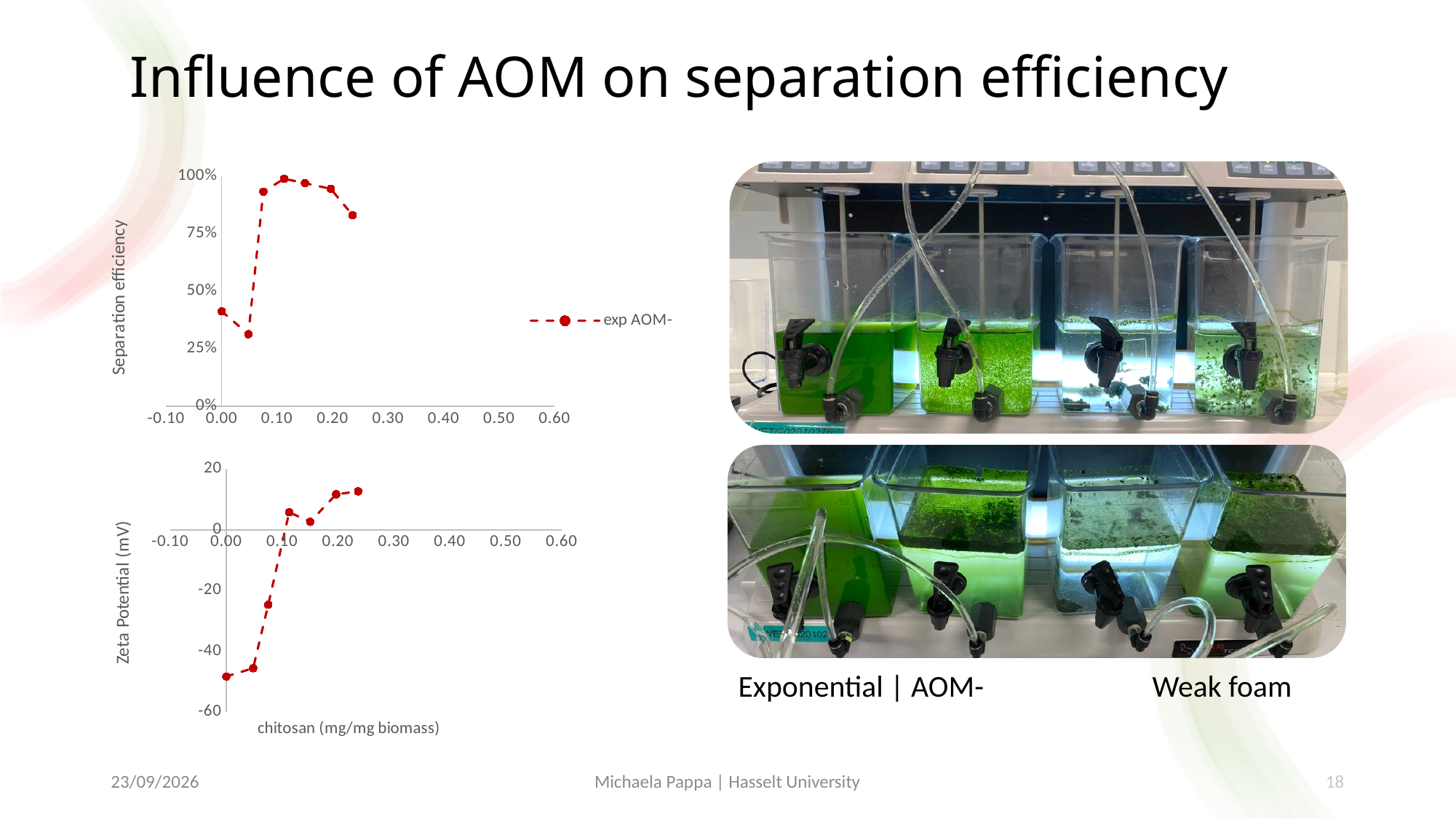
In the bottom chart, does the zeta potential generally rise or fall as the chitosan dose increases? rise In the bottom chart, is the zeta potential at a chitosan dose of 0.20 greater or less than 0 mV? greater What is the y-axis title of the bottom chart? Zeta Potential (mV) What is the name of the series in the legend of the top chart? exp AOM- What kind of chart is the top chart showing separation efficiency? line chart In the top chart, which is larger: the separation efficiency at a chitosan dose of 0.00 or at 0.10? 0.10 In the top chart, is the separation efficiency at the lowest point greater or less than 50%? less How many series does the legend of the top chart list? 1 In the top chart, is the separation efficiency at a chitosan dose of 0.00 greater or less than 50%? less How many data points are plotted in the bottom chart? 7